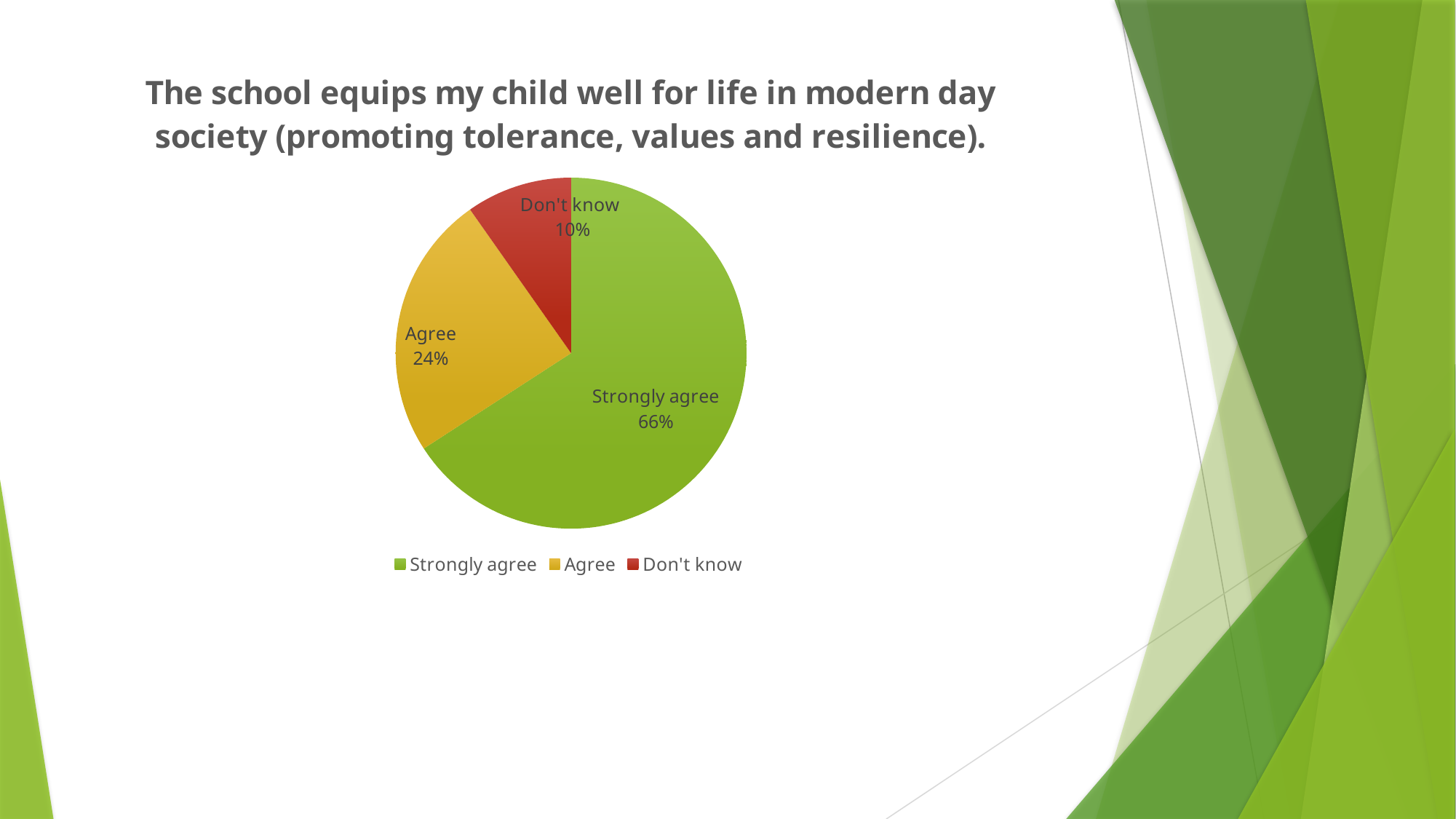
Which is larger, the share for 'Agree' or the share for 'Don't know'? Agree Which response has the largest share of the pie? Strongly agree Which response has the smallest share of the pie? Don't know What percentage of respondents chose 'Strongly agree'? 66% What is the difference in percentage points between 'Strongly agree' and 'Agree'? 42 What colour is the 'Don't know' slice? Red What is the combined share of 'Strongly agree' and 'Agree'? 90% What percentage of respondents chose 'Don't know'? 10% What kind of chart is shown on the slide? Pie chart How many slices does the pie chart have? 3 What is the difference in percentage points between 'Agree' and 'Don't know'? 14 What percentage of respondents chose 'Agree'? 24%